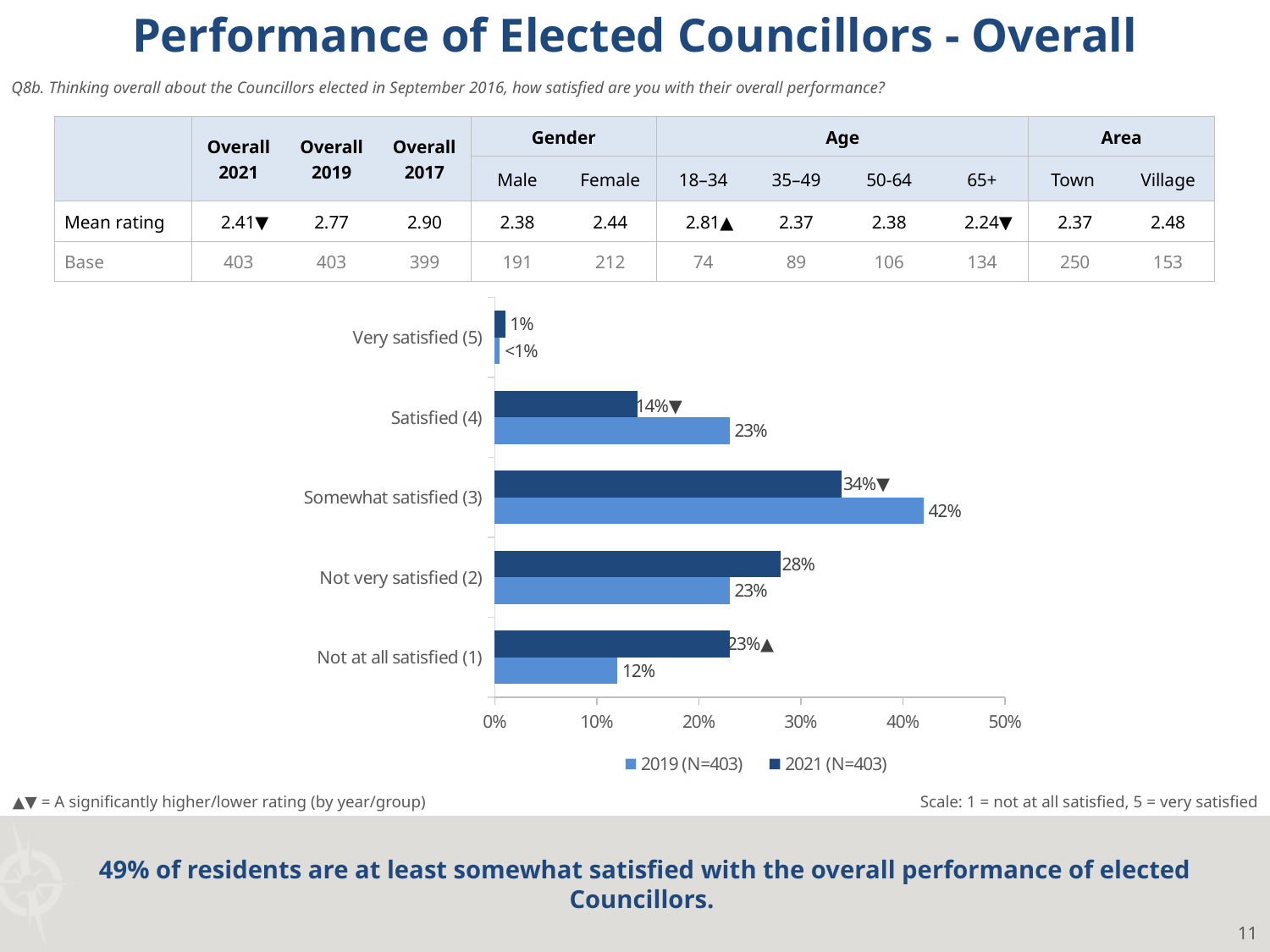
Which category has the lowest 2021 value? Very satisfied (5) What is the difference between the 2019 and 2021 values for Somewhat satisfied (3)? 8% For Not very satisfied (2), which year has the larger value, 2019 or 2021? 2021 What is the 2021 value for Somewhat satisfied (3)? 34% How many series does the chart legend list? 2 Which category has the highest 2019 value? Somewhat satisfied (3) How many satisfaction categories are plotted in the chart? 5 Which series is shown in dark blue in the chart? 2021 (N=403) What is the 2019 value for Satisfied (4)? 23% What type of chart is shown on the slide? bar chart What is the 2021 value for Not at all satisfied (1)? 23% What is the 2019 value for Very satisfied (5)? <1%